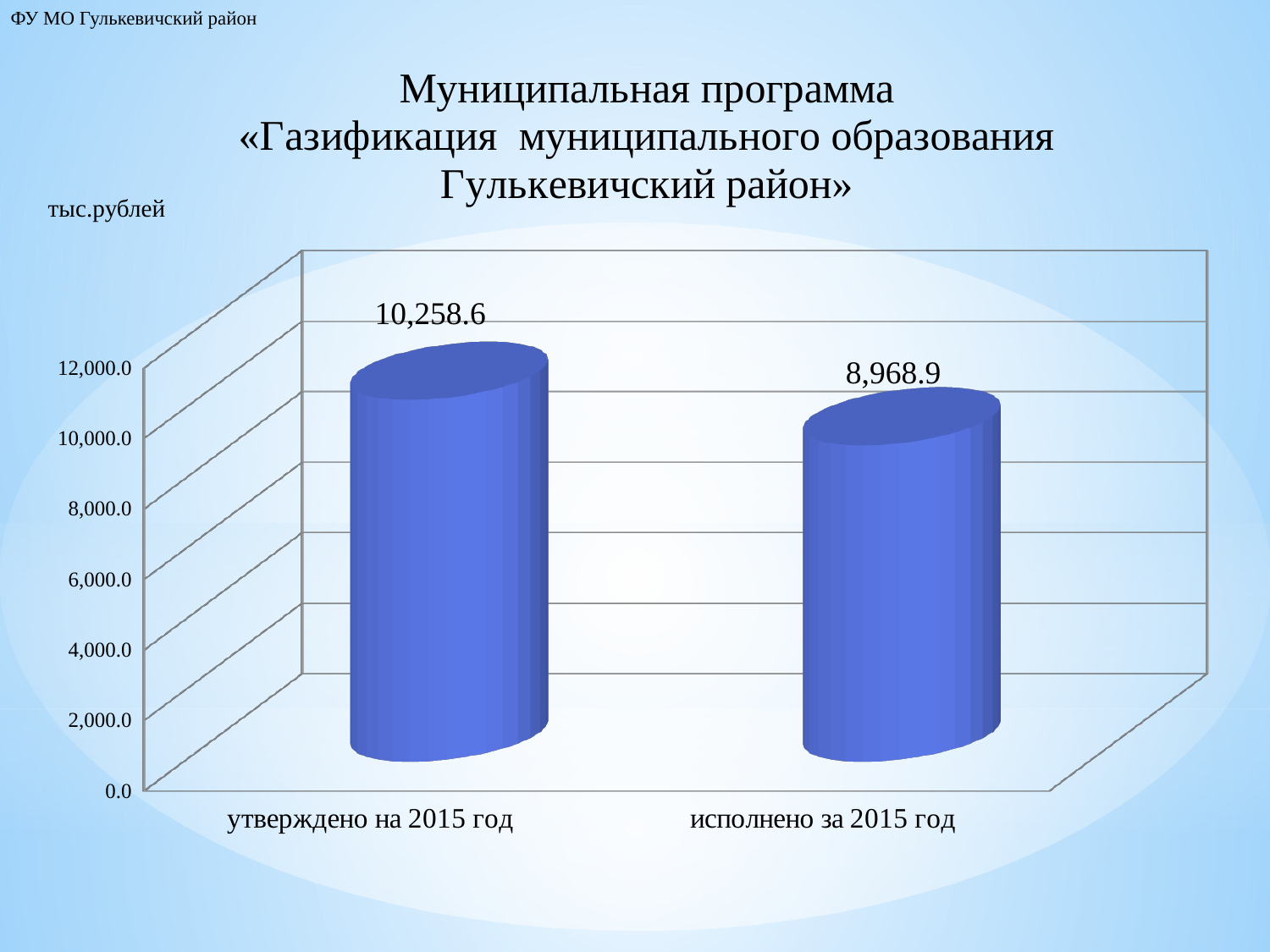
How many categories are shown on the chart? 2 Is the value for «исполнено за 2015 год» greater or less than 10,000.0? less What is the difference between the value for «утверждено на 2015 год» and the value for «исполнено за 2015 год»? 1,289.7 What is the value for «исполнено за 2015 год»? 8,968.9 Which is larger: the value for «утверждено на 2015 год» or the value for «исполнено за 2015 год»? утверждено на 2015 год What is the value for «утверждено на 2015 год»? 10,258.6 Do the values rise or fall from the first category to the second along the x axis? fall Is the value for «утверждено на 2015 год» greater or less than 10,000.0? greater What unit of measurement is indicated for the chart values? тыс.рублей What kind of chart is shown on the slide? bar chart Which category has the highest value? утверждено на 2015 год Which category has the lowest value? исполнено за 2015 год